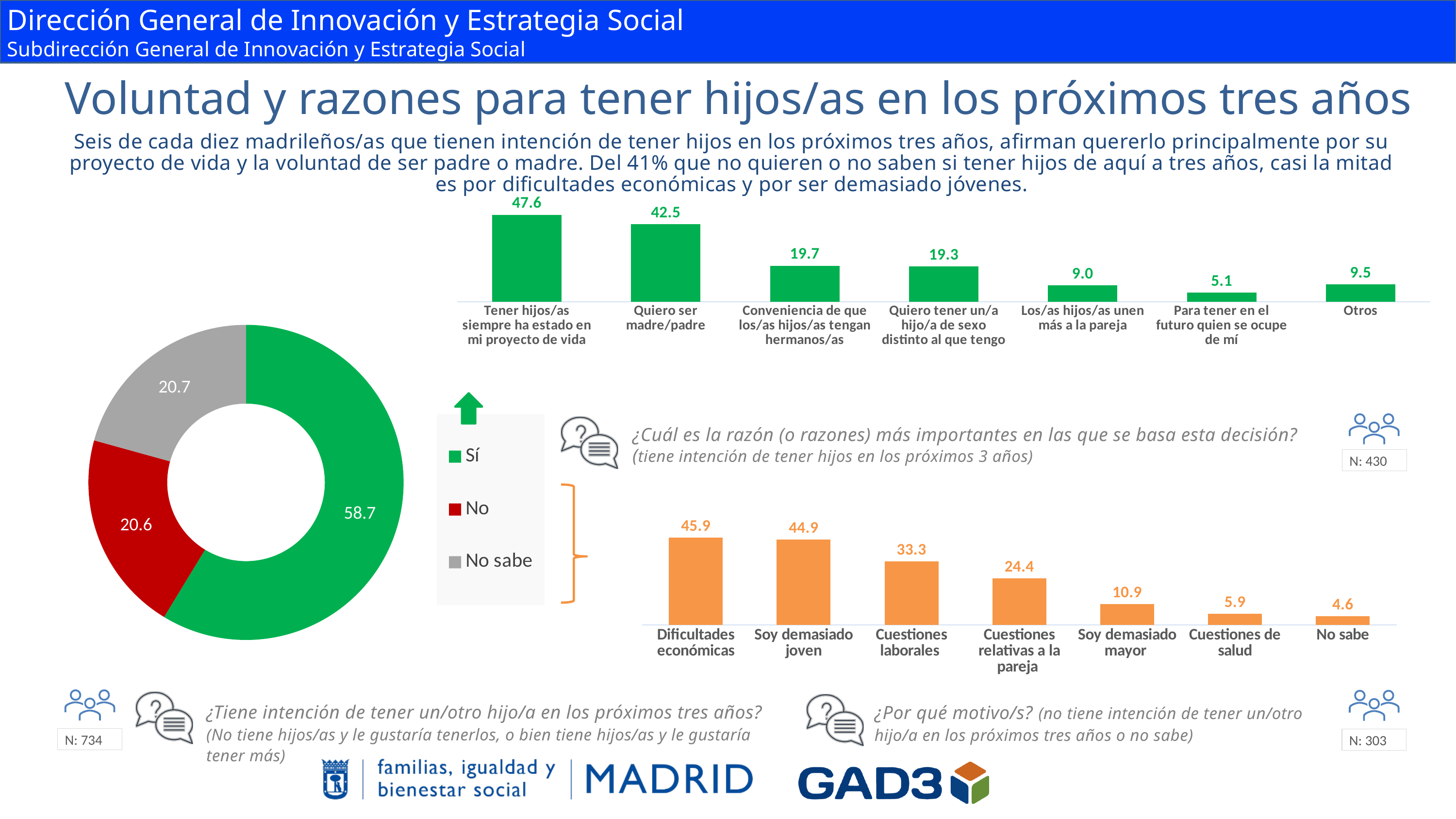
In the donut chart on the left, how many categories does the legend list? 3 What type of chart is the orange chart at the bottom right? Bar chart In the donut chart on the left, which category has the largest share? Sí In the green bar chart at the top right, what is the value for 'Quiero ser madre/padre'? 42.5 In the green bar chart at the top right, how many categories are shown? 7 In the orange bar chart at the bottom right, which category has the highest value? Dificultades económicas In the green bar chart at the top right, which category has the lowest value? Para tener en el futuro quien se ocupe de mí In the donut chart on the left, what is the value for 'No sabe'? 20.7 In the donut chart on the left, what is the value for 'Sí'? 58.7 In the orange bar chart at the bottom right, what is the value for 'Cuestiones laborales'? 33.3 In the orange bar chart at the bottom right, which is larger: 'Soy demasiado mayor' or 'Cuestiones de salud'? Soy demasiado mayor In the green bar chart at the top right, what is the difference between 'Tener hijos/as siempre ha estado en mi proyecto de vida' and 'Quiero ser madre/padre'? 5.1